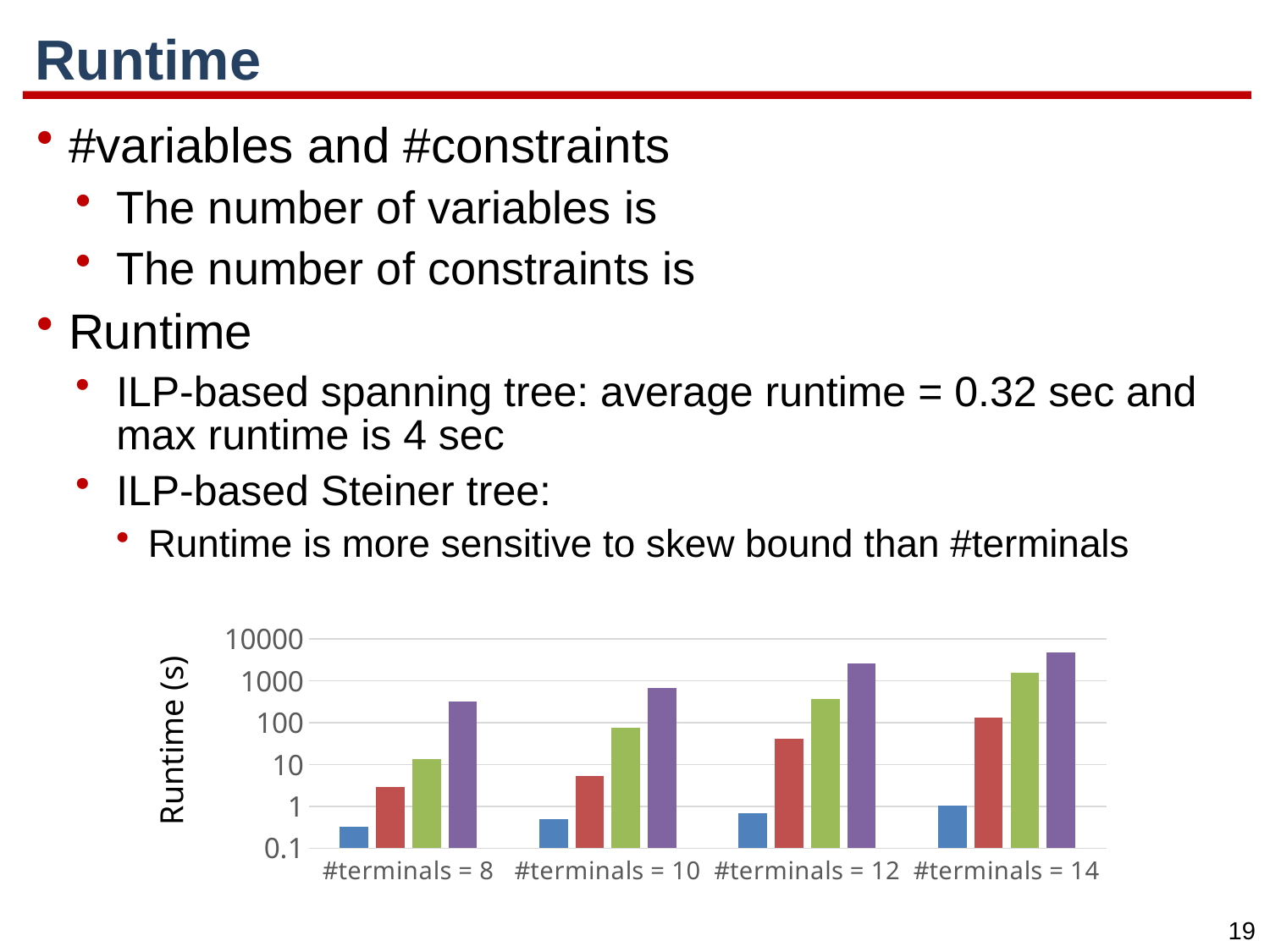
Is the value of the purple bar for #terminals = 10 greater or less than 1000? less Which bar in the chart has the highest runtime? the purple bar for #terminals = 14 Do the purple bars rise or fall as #terminals increases from 8 to 14? rise Is the value of the purple bar for #terminals = 14 greater or less than 1000? greater What is the label of the y axis of the chart? Runtime (s) Which bar in the chart has the lowest runtime? the blue bar for #terminals = 8 What is the highest tick value shown on the y axis of the chart? 10000 Is the value of the blue bar for #terminals = 8 greater or less than 1? less How many #terminals categories are shown on the x axis of the chart? 4 What kind of chart is shown on the slide? bar chart How many bars are plotted in each #terminals group of the chart? 4